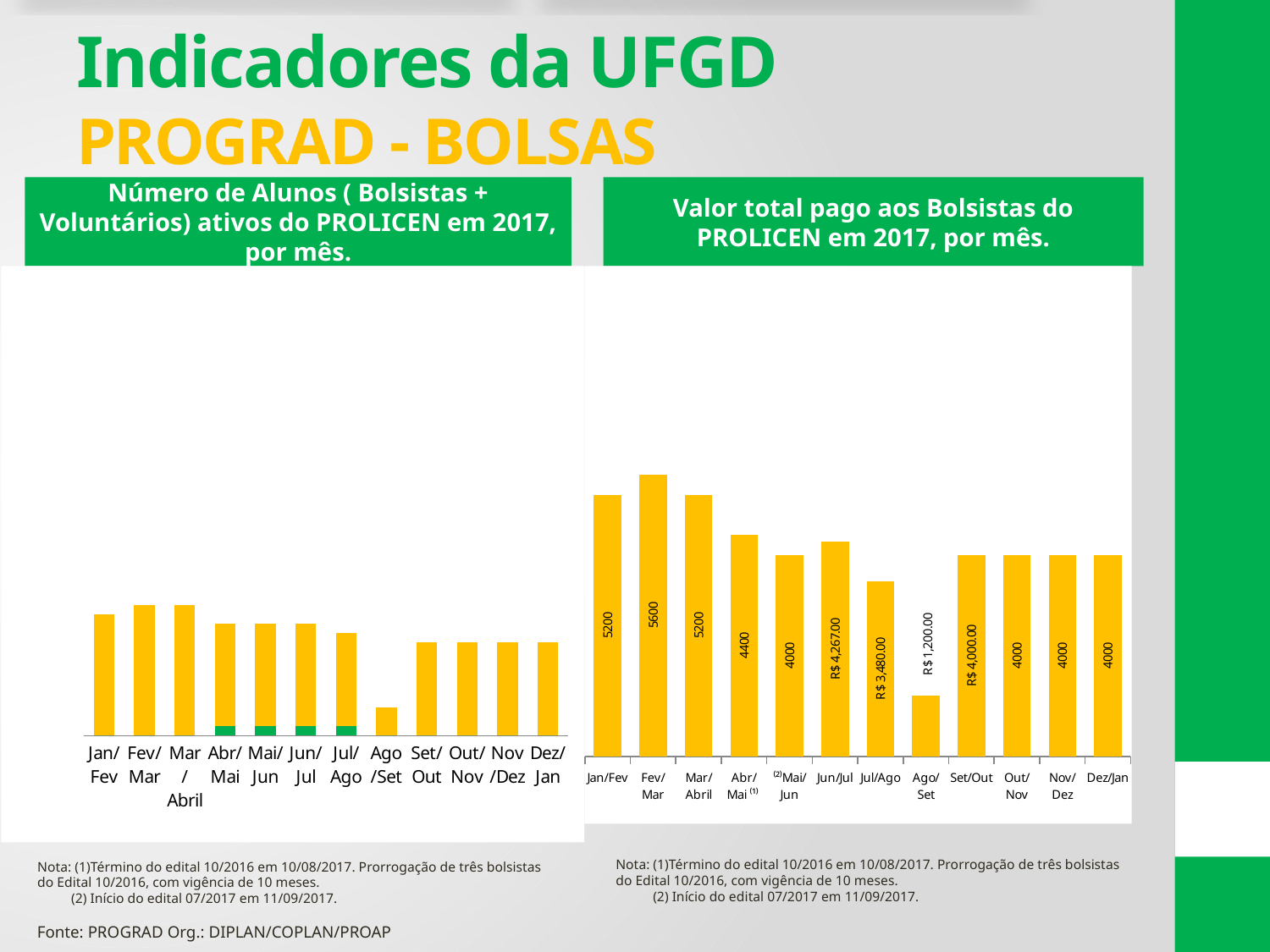
In the chart 'Valor total pago aos Bolsistas do PROLICEN em 2017, por mês', what is the value for Ago/Set? R$ 1,200.00 In the chart 'Valor total pago aos Bolsistas do PROLICEN em 2017, por mês', what is the value for Jun/Jul? R$ 4,267.00 In the chart 'Valor total pago aos Bolsistas do PROLICEN em 2017, por mês', what is the difference between the values for Fev/Mar and Jan/Fev? 400 In the chart 'Valor total pago aos Bolsistas do PROLICEN em 2017, por mês', what is the value for Jul/Ago? R$ 3,480.00 In the chart 'Valor total pago aos Bolsistas do PROLICEN em 2017, por mês', how many periods are shown on the x axis? 12 In the chart 'Valor total pago aos Bolsistas do PROLICEN em 2017, por mês', which is larger: the value for Abr/Mai or the value for Jul/Ago? Abr/Mai In the chart 'Valor total pago aos Bolsistas do PROLICEN em 2017, por mês', which period has the lowest value? Ago/Set In the chart 'Valor total pago aos Bolsistas do PROLICEN em 2017, por mês', what is the value for Fev/Mar? 5600 What kind of chart is the chart 'Número de Alunos (Bolsistas + Voluntários) ativos do PROLICEN em 2017, por mês'? Bar chart In the chart 'Valor total pago aos Bolsistas do PROLICEN em 2017, por mês', which period has the highest value? Fev/Mar In the chart 'Número de Alunos (Bolsistas + Voluntários) ativos do PROLICEN em 2017, por mês', how many bars include a green segment? 4 In the chart 'Número de Alunos (Bolsistas + Voluntários) ativos do PROLICEN em 2017, por mês', which period has the lowest bar? Ago/Set